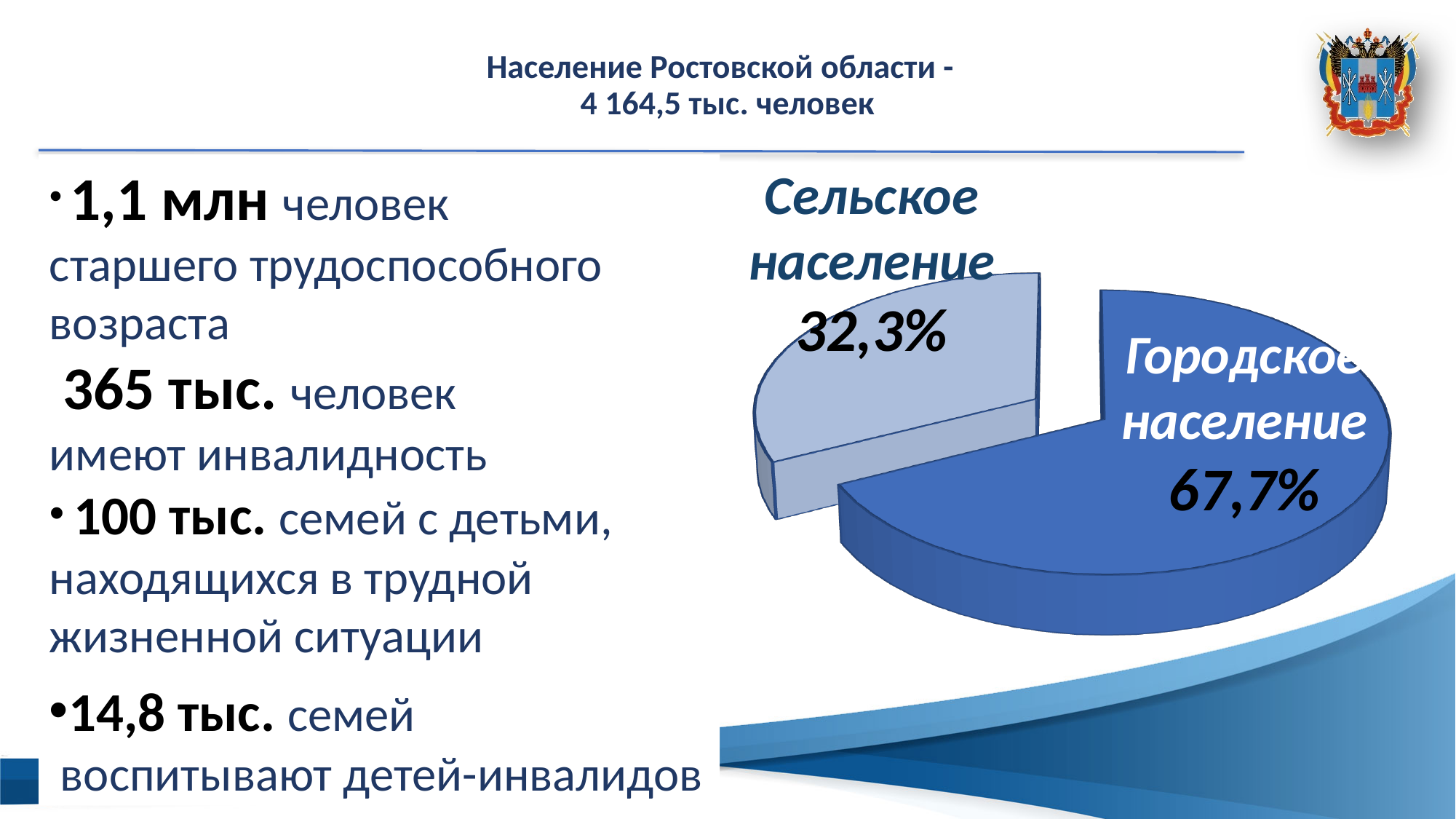
What is the difference in percentage points between the Городское население and Сельское население slices? 35,4 Which slice of the pie chart is the largest? Городское население What is the total of the two slices shown in the pie chart? 100% Which slice of the pie chart is drawn in the lighter blue colour? Сельское население Which slice of the pie chart is the smallest? Сельское население How many slices does the pie chart have? 2 What share of the pie does Городское население have? 67,7% What kind of chart is shown on the slide? pie chart Which slice of the pie chart is pulled out (exploded) from the rest of the pie? Сельское население What share of the pie does Сельское население have? 32,3% Which is larger, the share for Городское население or the share for Сельское население? Городское население